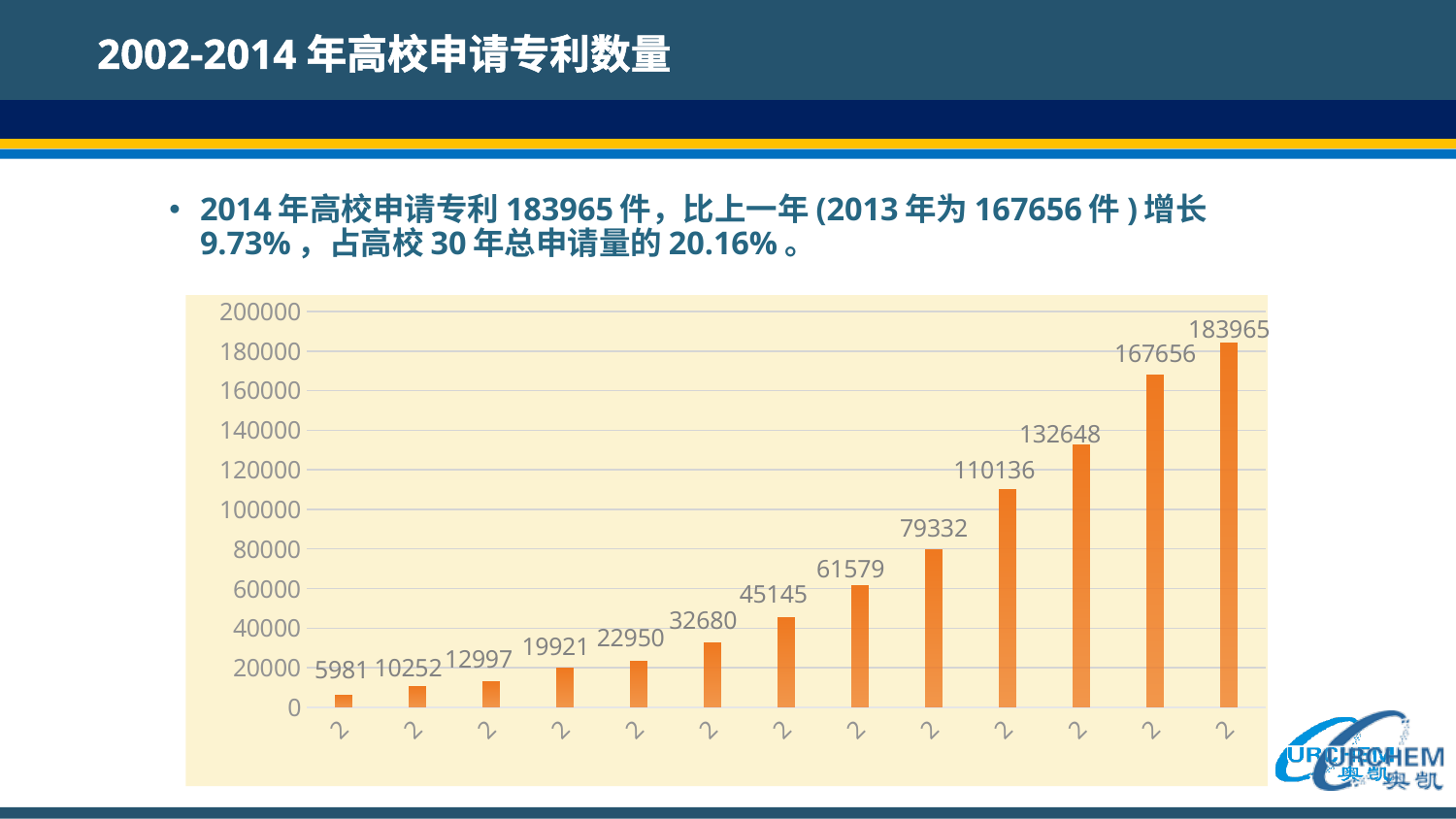
What is the value labelled on the second bar from the left? 10252 What is the highest value shown on the vertical axis of the chart? 200000 What is the value labelled on the fifth bar from the left? 22950 How many bars are plotted in the chart? 13 What is the value labelled on the tenth bar from the left? 110136 What is the difference between the values of the rightmost bar (183965) and the bar just before it (167656)? 16309 Do the bar values rise or fall from left to right along the x axis? rise What is the value shown on the shortest (leftmost) bar in the chart? 5981 What is the value labelled on the second bar from the right? 167656 Which is larger, the value of the seventh bar from the left (45145) or the eighth bar from the left (61579)? 61579 What type of chart is shown on the slide? bar chart What is the value shown on the tallest (rightmost) bar in the chart? 183965